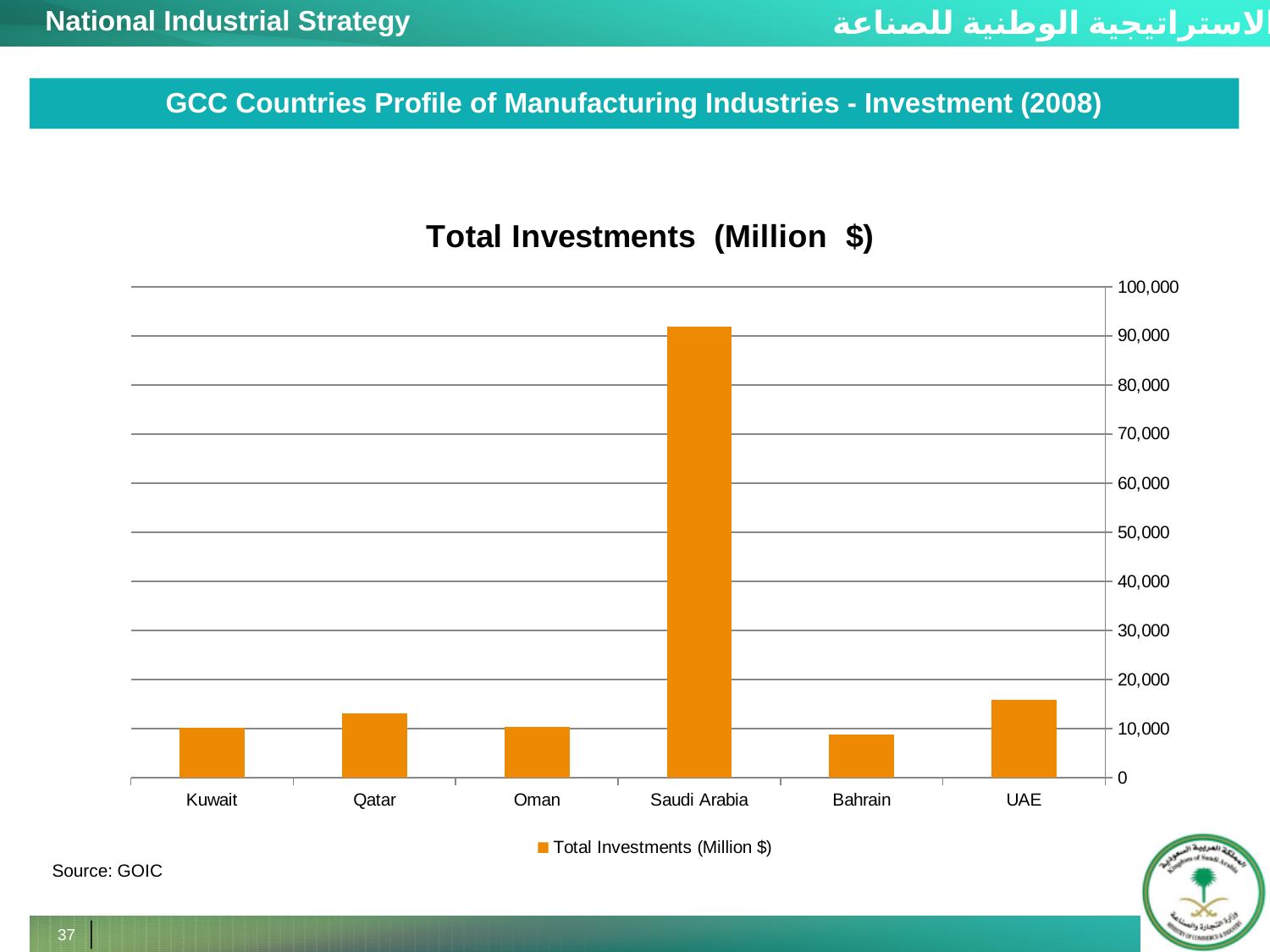
How many series does the legend list? 1 Is the value for Saudi Arabia greater or less than 80,000? greater What is the title of the chart? Total Investments (Million $) How many countries are shown on the x axis? 6 Is the value for Bahrain greater or less than 10,000? less Is the value for UAE greater or less than 10,000? greater Which country has the lowest total investments? Bahrain Which country has the highest total investments? Saudi Arabia What colour are the bars in the chart? Orange What kind of chart is shown on the slide? Bar chart Which has larger total investments, UAE or Qatar? UAE